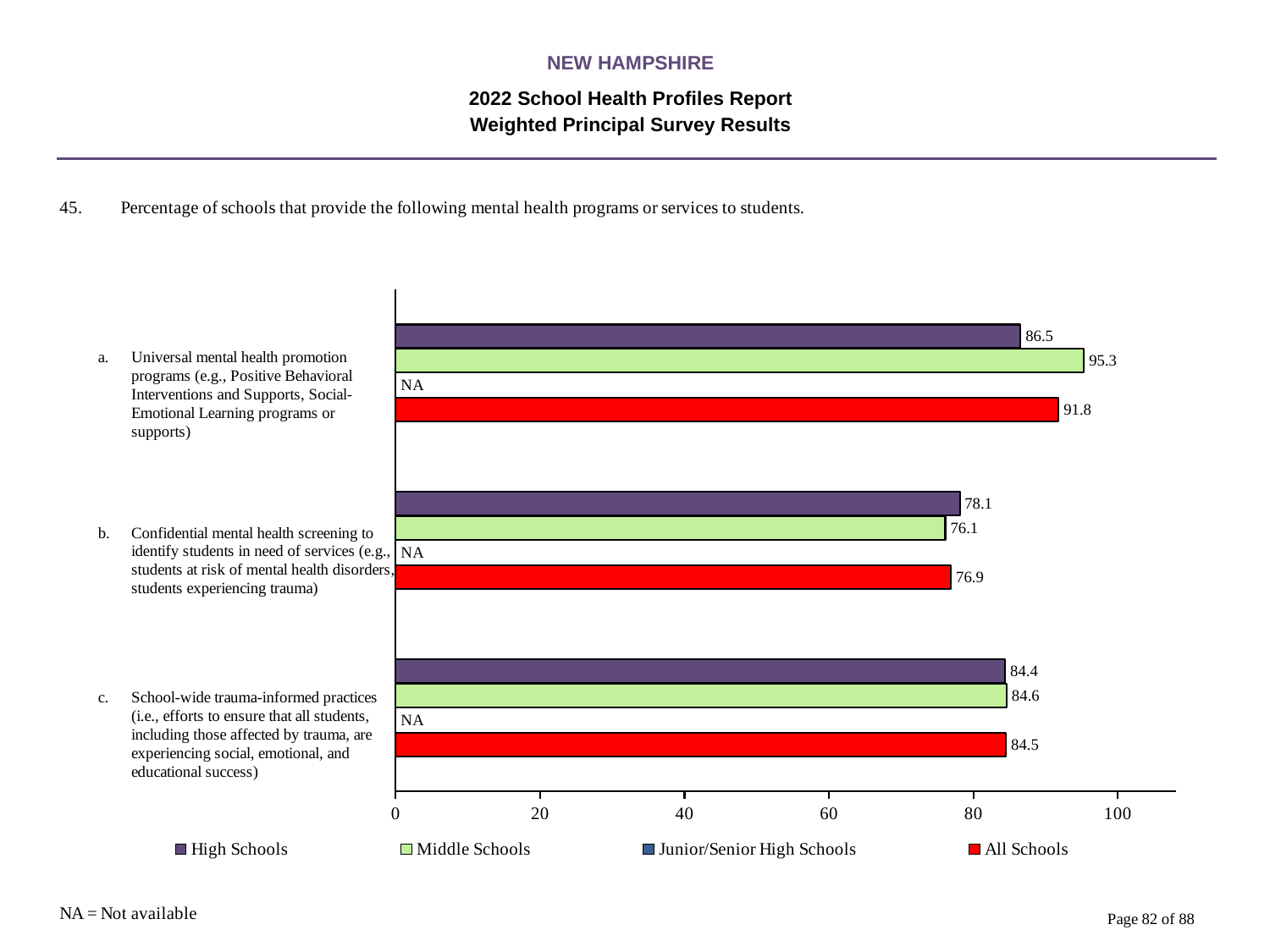
What is the value for High Schools for universal mental health promotion programs (item a)? 86.5 How many mental health programs or services (categories) are shown on the chart? 3 Which school type has the lowest value for confidential mental health screening (item b)? Middle Schools How many series does the legend list? 4 What kind of chart is shown on the slide? Bar chart What colour are the All Schools bars? Red What is the value for Middle Schools for confidential mental health screening (item b)? 76.1 What value is shown for Junior/Senior High Schools for universal mental health promotion programs (item a)? NA Which school type has the highest value for universal mental health promotion programs (item a)? Middle Schools What is the value for All Schools for school-wide trauma-informed practices (item c)? 84.5 What is the difference between the Middle Schools and High Schools values for universal mental health promotion programs (item a)? 8.8 For confidential mental health screening (item b), which is larger: the High Schools value or the All Schools value? High Schools